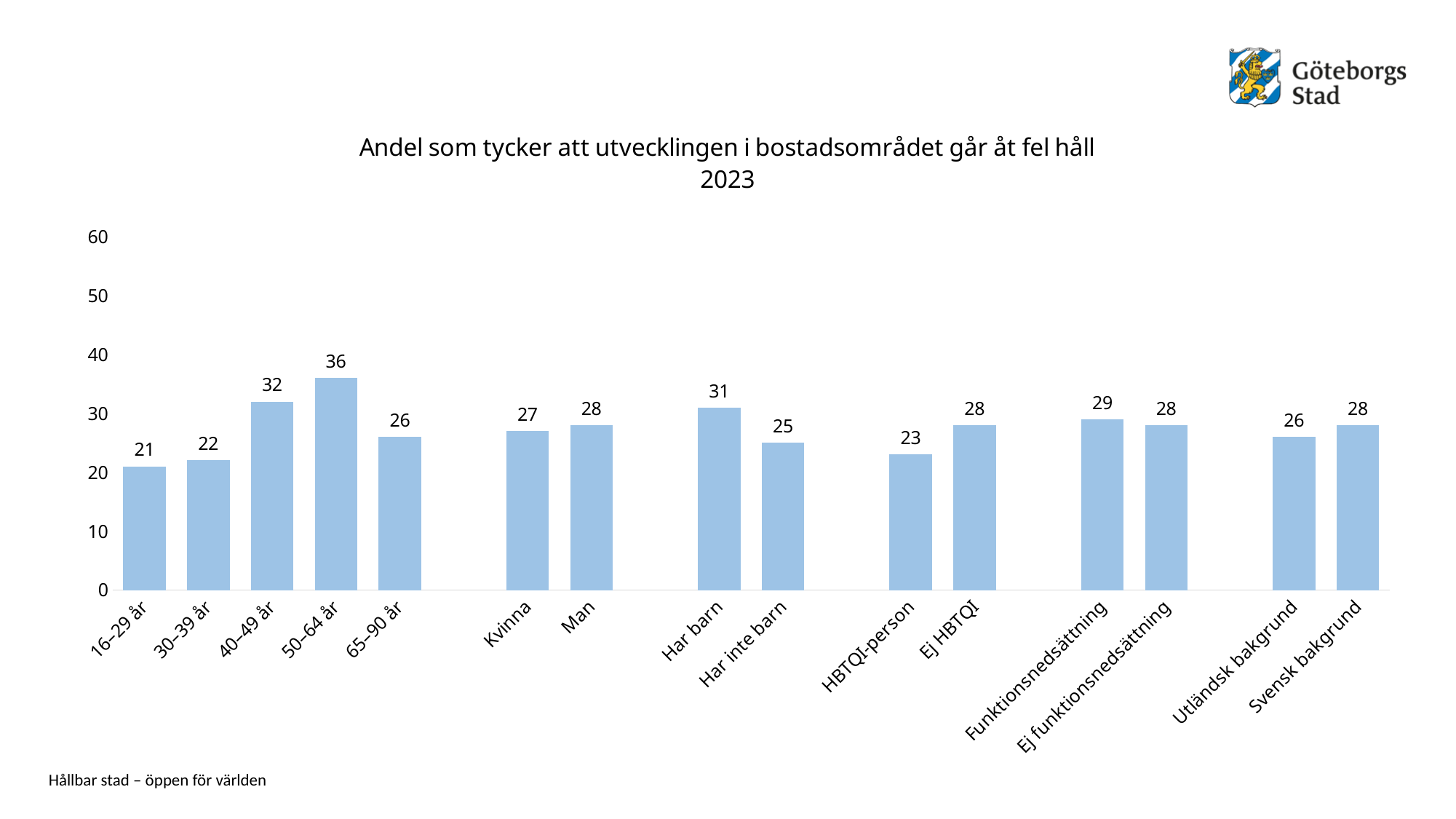
Which is larger, the value for Kvinna or the value for Man? Man What year is shown in the chart title? 2023 What is the difference between the values for Har barn and Har inte barn? 6 Is the value for 40–49 år greater or less than 30? greater Which category has the lowest value? 16–29 år What is the value for Har barn? 31 What kind of chart is shown? bar chart How many categories are shown on the x axis? 16 Which category has the highest value? 50–64 år What is the value for HBTQI-person? 23 What is the difference between the values for Funktionsnedsättning and Ej funktionsnedsättning? 1 What is the value for 50–64 år? 36